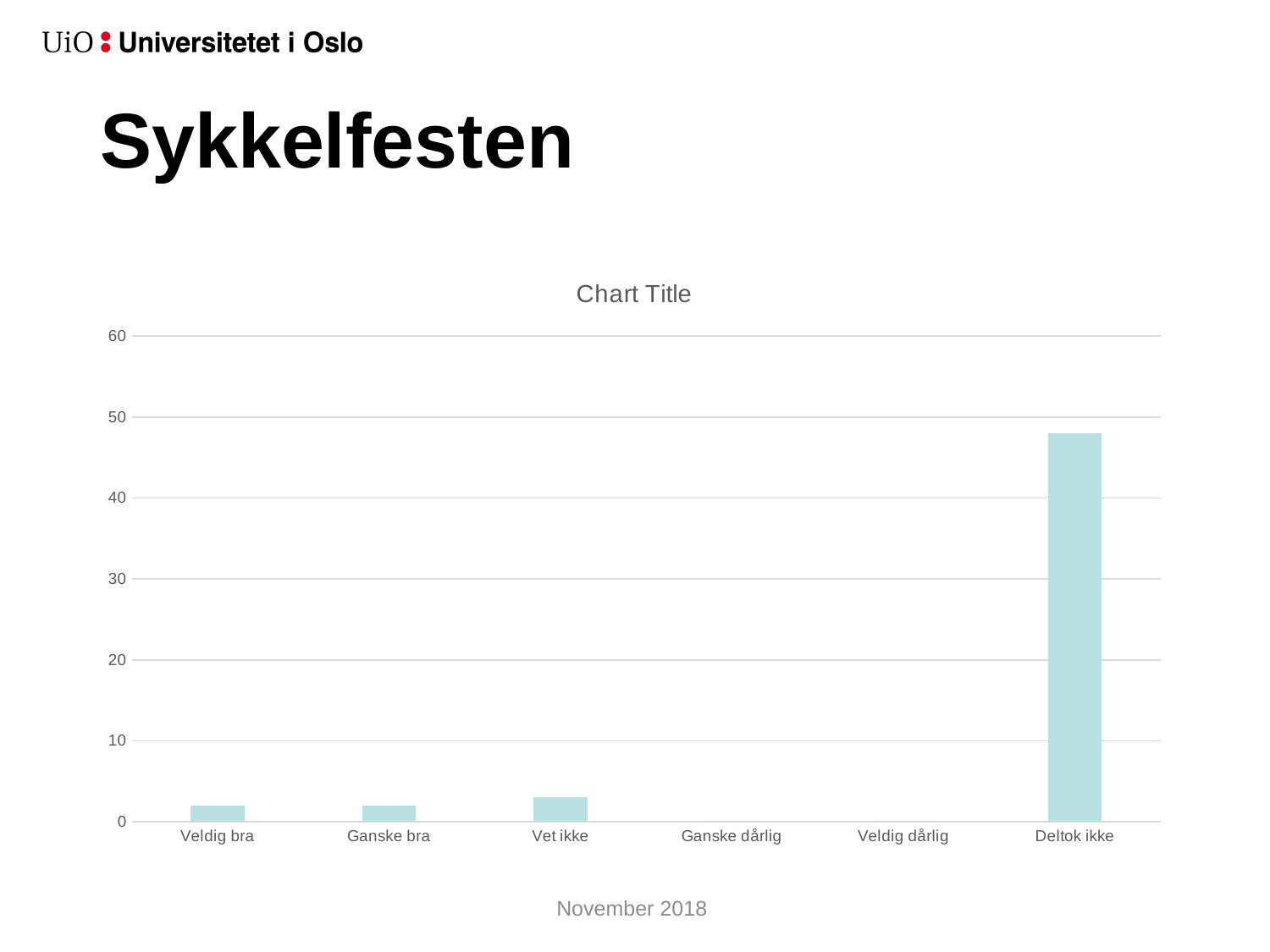
Which is larger, the value for Deltok ikke or the value for Veldig bra? Deltok ikke Is the value for Vet ikke greater or less than 10? less Is the value for Deltok ikke greater or less than 40? greater What is the highest value shown on the chart's vertical axis? 60 Which is larger, the value for Vet ikke or the value for Deltok ikke? Deltok ikke Is the value for Veldig bra greater or less than 10? less What kind of chart is shown on the slide? bar chart What is the title shown above the chart? Chart Title What is the value for Ganske dårlig in the chart? 0 Which category has the highest value in the chart? Deltok ikke How many categories are shown on the x axis of the chart? 6